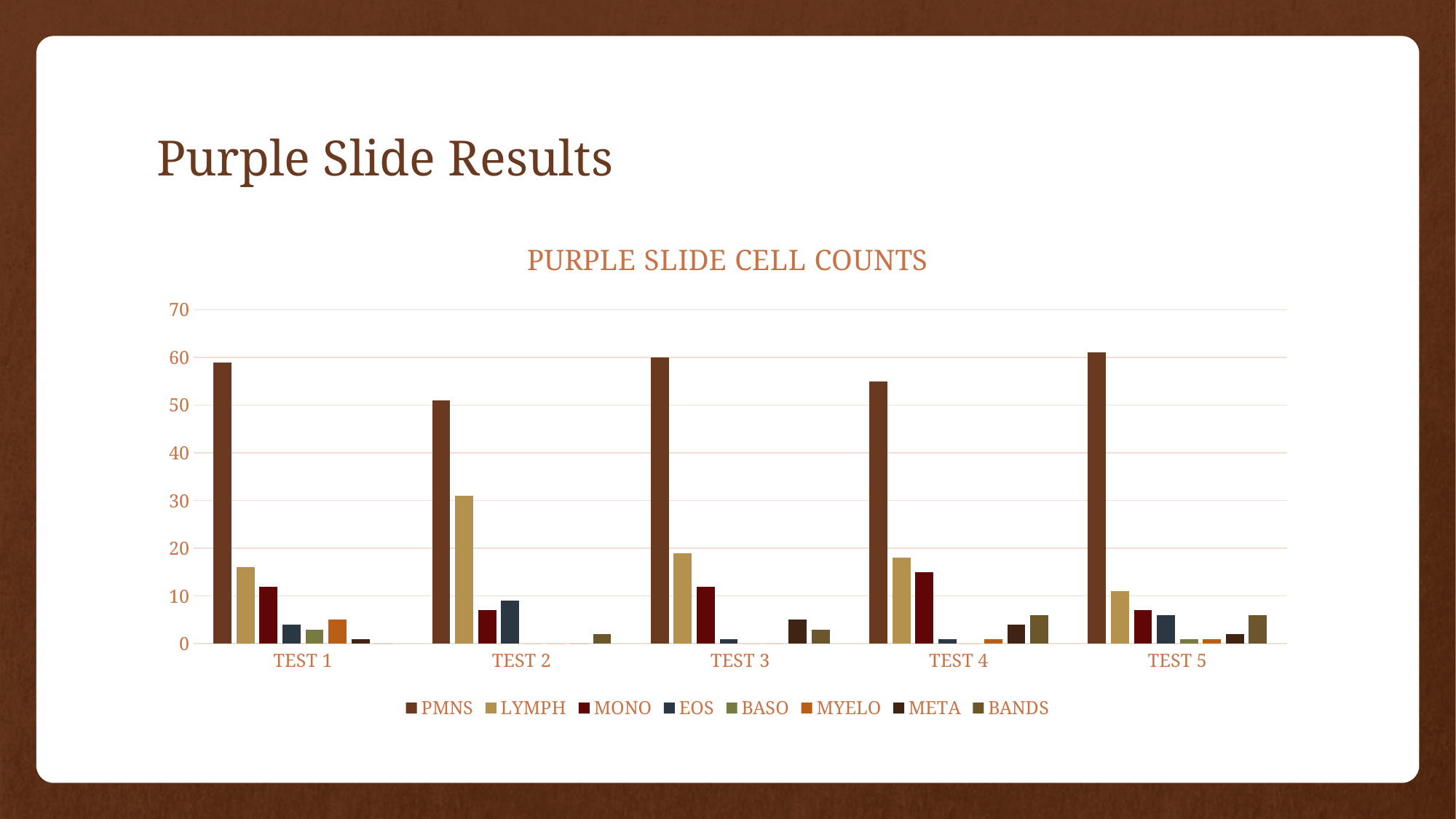
What is the title of the chart? PURPLE SLIDE CELL COUNTS How many series does the legend list? 8 Is the MONO value for TEST 4 greater or less than 20? less Which series is listed first in the legend? PMNS Which is larger, the PMNS value for TEST 1 or the PMNS value for TEST 2? TEST 1 How many test categories are shown on the x axis? 5 Is the LYMPH value for TEST 2 greater or less than 20? greater What kind of chart is shown on the slide? bar chart In which test is the LYMPH value highest? TEST 2 Is the PMNS value for TEST 1 greater or less than 50? greater Which is larger, the LYMPH value for TEST 2 or the LYMPH value for TEST 5? TEST 2